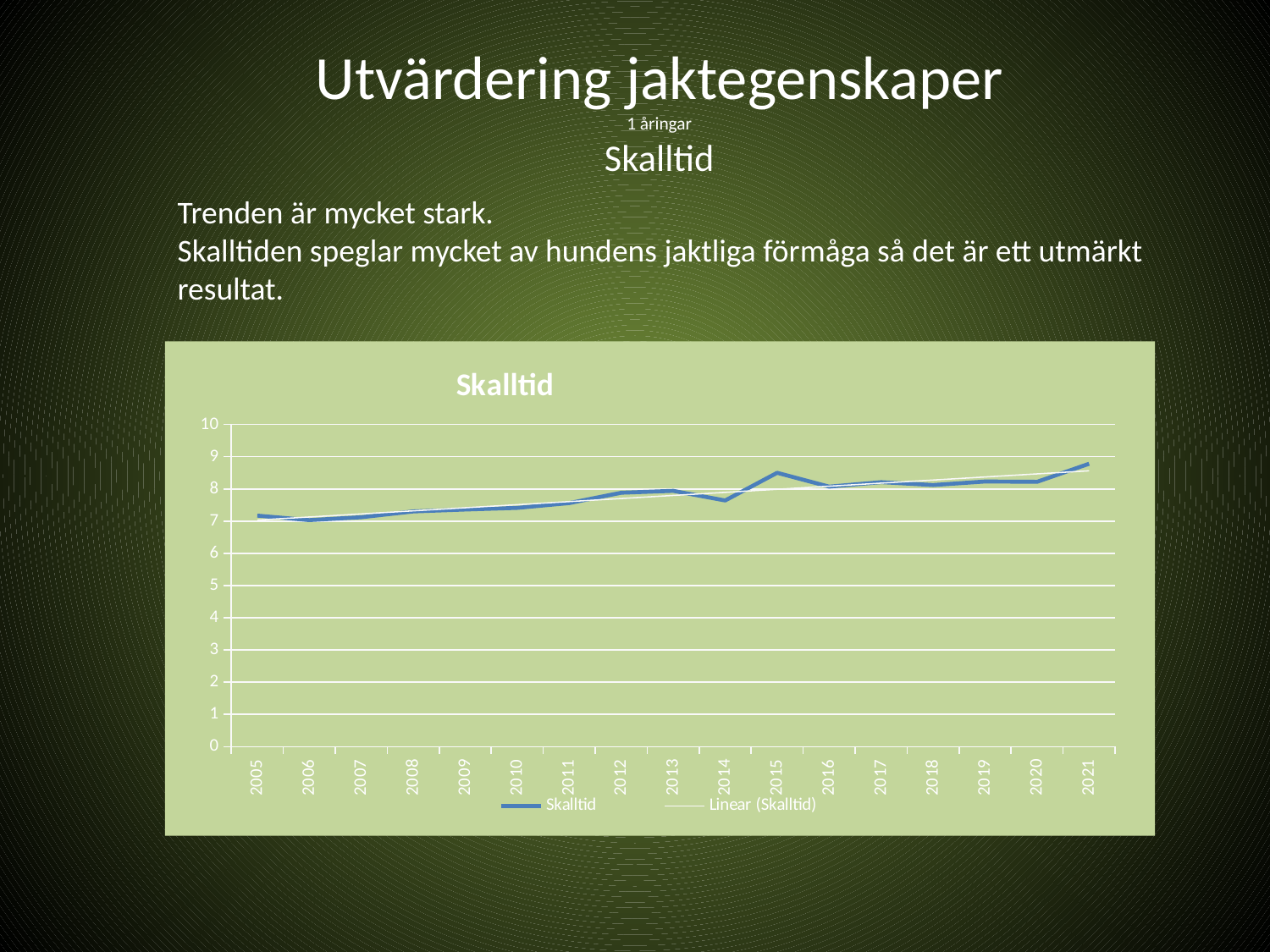
Is the Skalltid value for 2010 greater or less than 7? greater Which year has the larger Skalltid value, 2014 or 2015? 2015 Is the Skalltid value for 2021 greater or less than 9? less Do the Skalltid values generally rise or fall from 2005 to 2021? rise Which year has the larger Skalltid value, 2005 or 2021? 2021 Is the Skalltid value for 2014 greater or less than 8? less How many entries does the chart legend list? 2 How many years are plotted along the x axis of the chart? 17 What is the title of the chart? Skalltid What kind of chart is shown on the slide? line chart